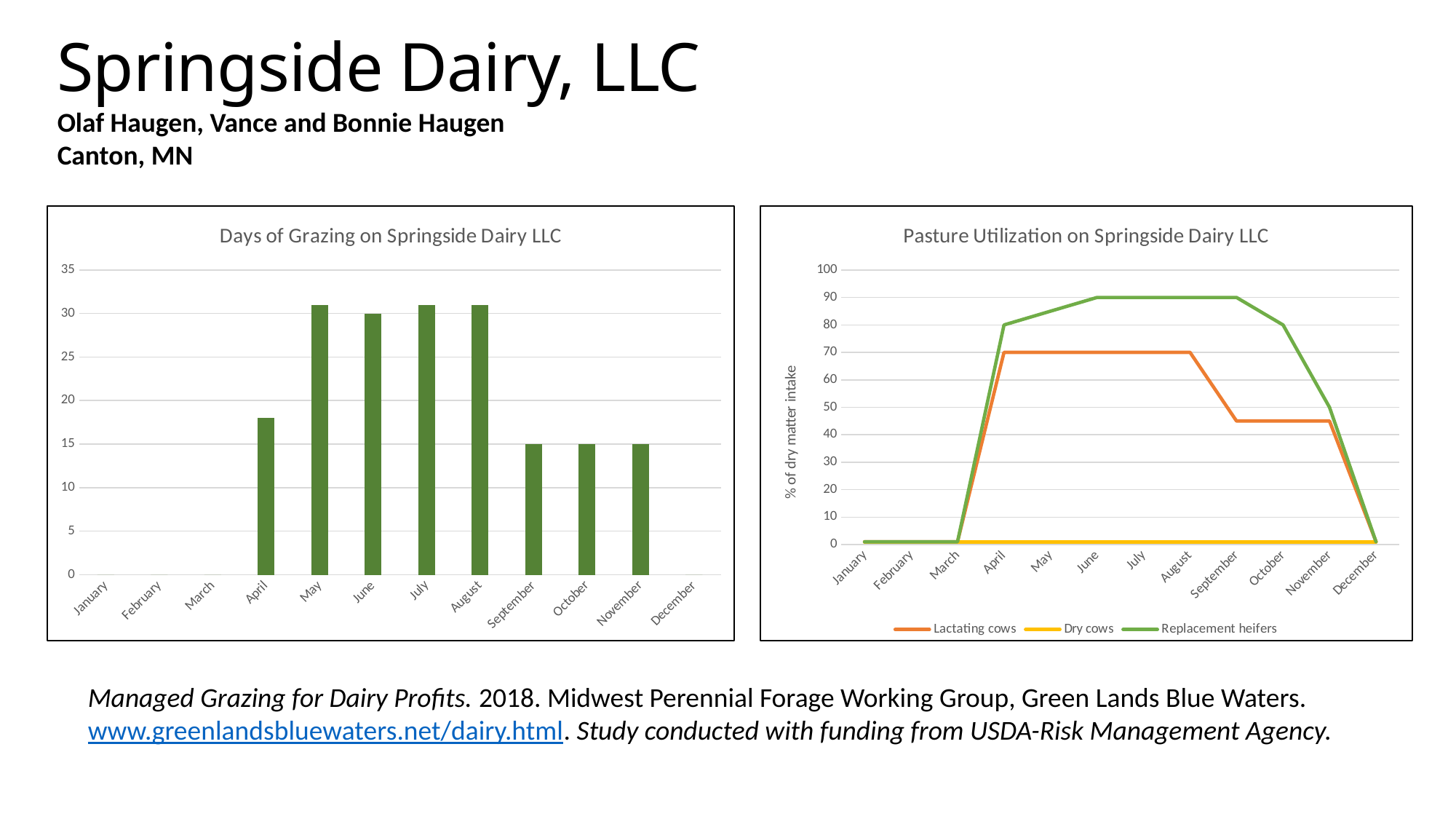
In the 'Pasture Utilization on Springside Dairy LLC' chart, what is the label on the vertical axis? % of dry matter intake In the 'Days of Grazing on Springside Dairy LLC' chart, how many days of grazing are shown for June? 30 In the 'Pasture Utilization on Springside Dairy LLC' chart, how many series does the legend list? 3 What kind of chart is the 'Days of Grazing on Springside Dairy LLC' chart? bar chart In the 'Days of Grazing on Springside Dairy LLC' chart, how many days of grazing are shown for September? 15 In the 'Days of Grazing on Springside Dairy LLC' chart, is the value for April greater or less than 20? less What kind of chart is the 'Pasture Utilization on Springside Dairy LLC' chart? line chart In the 'Pasture Utilization on Springside Dairy LLC' chart, which series has the higher value in September, Lactating cows or Replacement heifers? Replacement heifers In the 'Pasture Utilization on Springside Dairy LLC' chart, what is the value for Replacement heifers in June? 90 In the 'Days of Grazing on Springside Dairy LLC' chart, how many months have a bar with a value above zero? 8 In the 'Pasture Utilization on Springside Dairy LLC' chart, what is the value for Lactating cows in April? 70